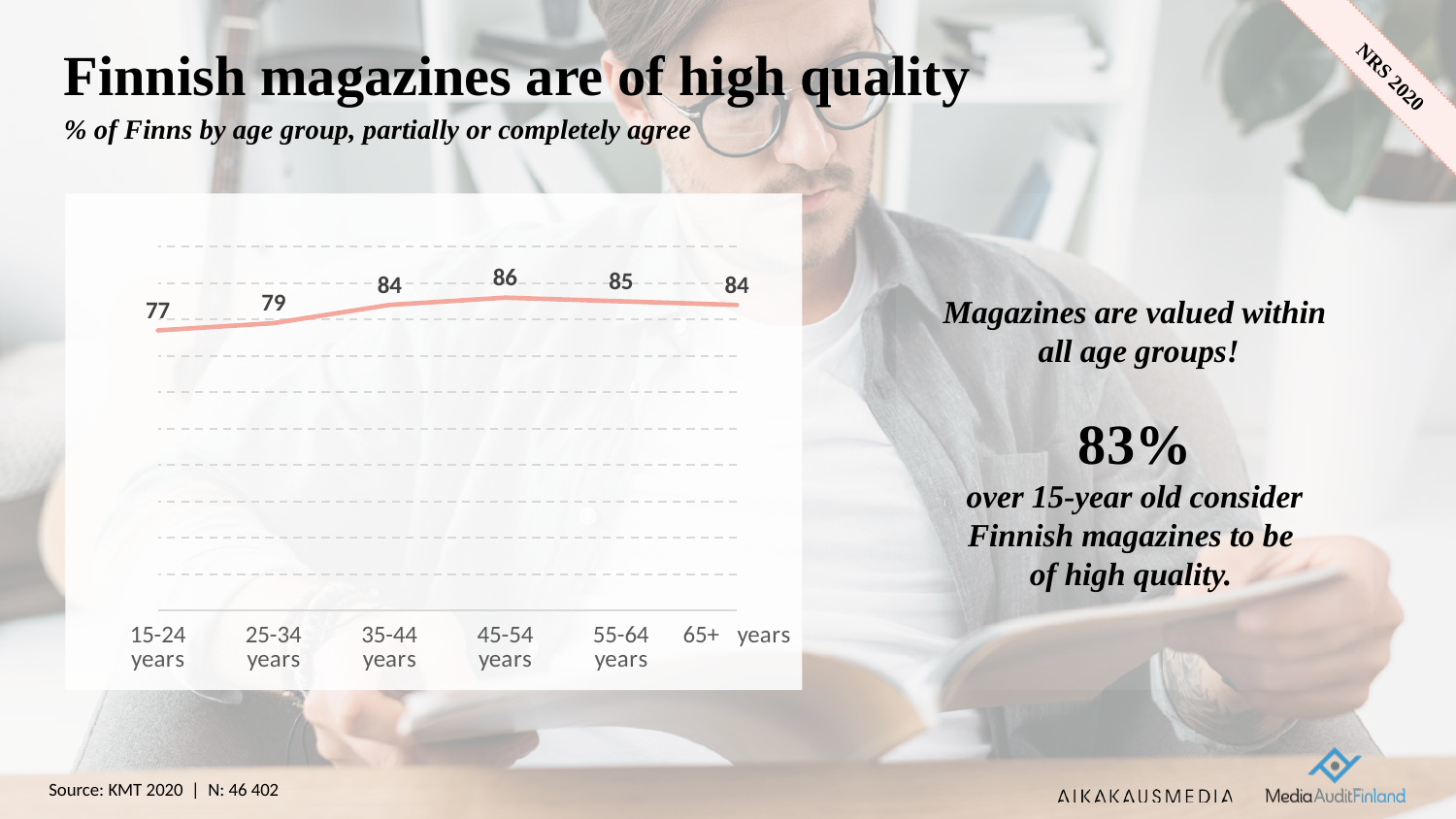
How many age groups are plotted on the chart? 6 What is the difference between the values for 45-54 years and 15-24 years? 9 Which is larger, the value for 25-34 years or the value for 55-64 years? 55-64 years What is the value for the 15-24 years age group? 77 What is the value for the 65+ years age group? 84 What is the value for the 45-54 years age group? 86 Which age group has the highest value? 45-54 years Do the values rise or fall from 15-24 years to 45-54 years? rise What is the title of the slide containing the chart? Finnish magazines are of high quality What is the difference between the values for 35-44 years and 25-34 years? 5 Which age group has the lowest value? 15-24 years What kind of chart is shown on the slide? line chart